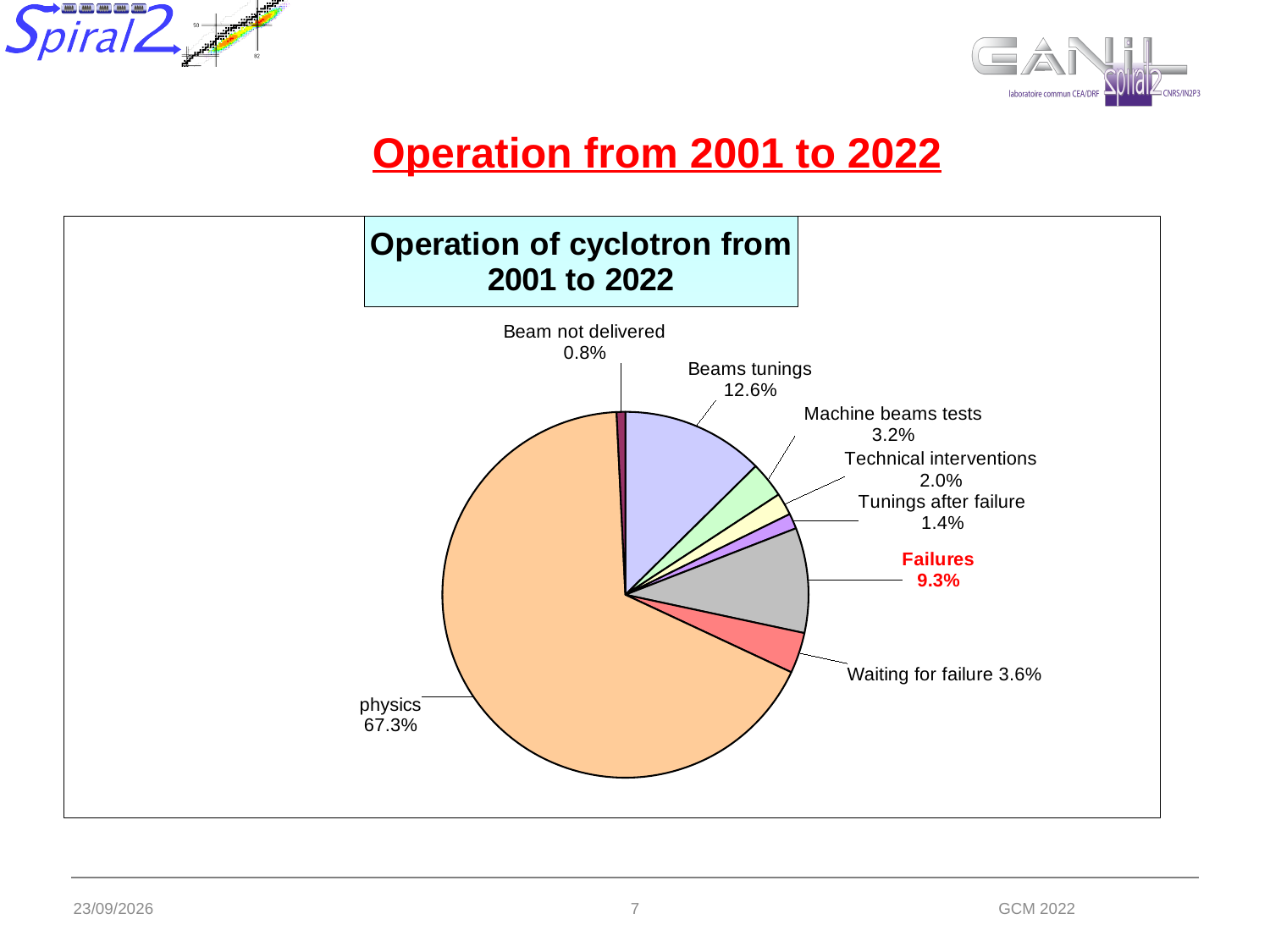
What percentage of the pie is labelled physics? 67.3% How many slices does the pie chart have? 8 What is the difference between Beams tunings and Failures? 3.3% Which category has the smallest slice of the pie? Beam not delivered What is the value shown for Failures? 9.3% What type of chart is shown on the slide? pie chart Which category has the largest slice of the pie? physics What is the value shown for Beam not delivered? 0.8% What is the title of the chart? Operation of cyclotron from 2001 to 2022 What is the value shown for Beams tunings? 12.6% Which is larger, Machine beams tests or Technical interventions? Machine beams tests What is the value shown for Waiting for failure? 3.6%